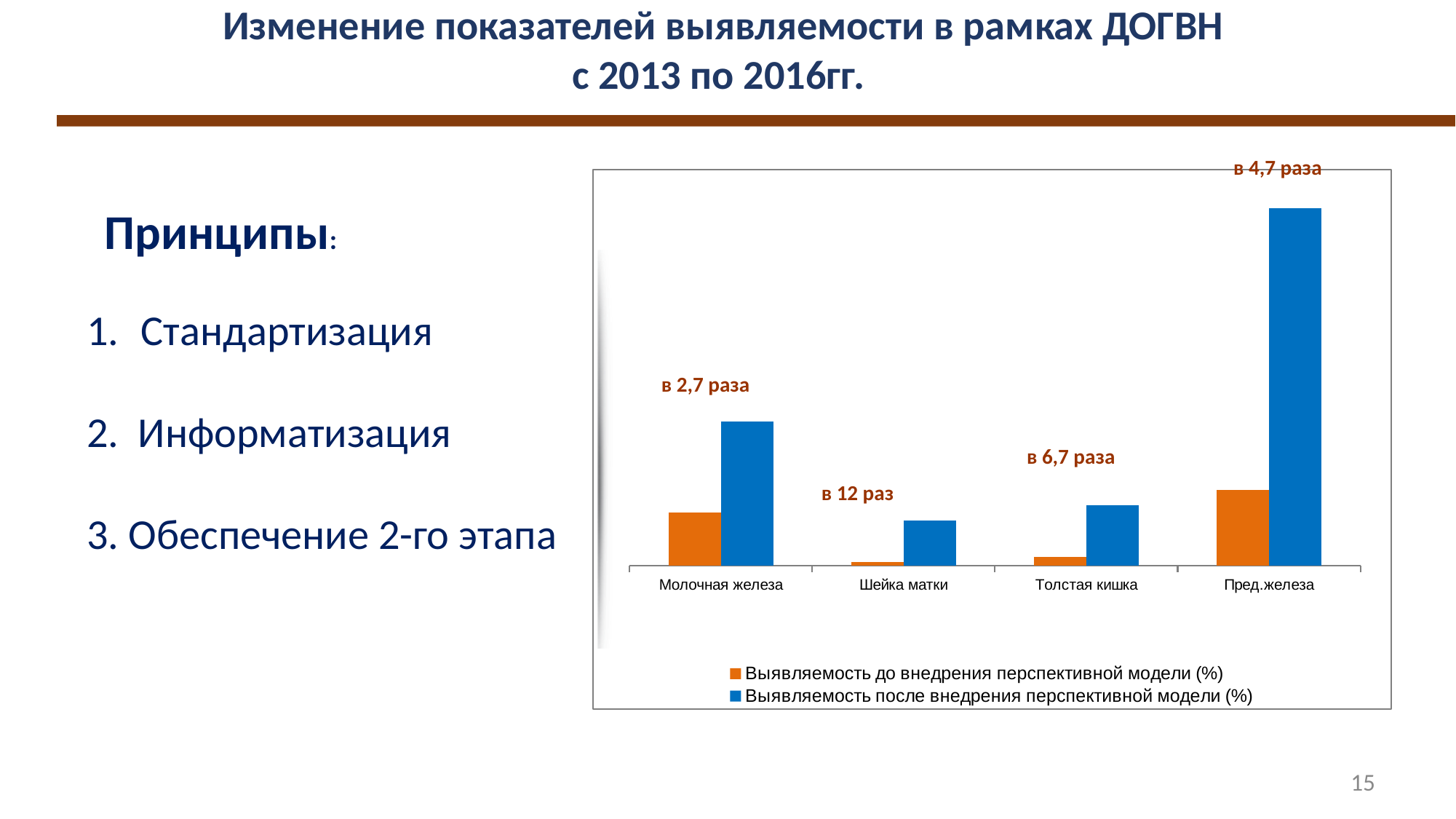
How many series does the chart legend list? 2 How many categories are shown on the x axis of the chart? 4 For 'Молочная железа', which is larger: the value before or after the introduction of the model? after Which category has the highest value for 'Выявляемость до внедрения перспективной модели (%)'? Пред.железа What growth factor is annotated above the bars for 'Шейка матки'? в 12 раз What kind of chart is shown on the slide? bar chart What growth factor is annotated above the bars for 'Толстая кишка'? в 6,7 раза For 'Пред.железа', which series has the larger value: 'до внедрения' or 'после внедрения'? после внедрения What colour are the bars for 'Выявляемость до внедрения перспективной модели (%)'? orange Which category has the highest value for 'Выявляемость после внедрения перспективной модели (%)'? Пред.железа Which category has the lowest value for 'Выявляемость до внедрения перспективной модели (%)'? Шейка матки What growth factor is annotated above the bars for 'Пред.железа'? в 4,7 раза